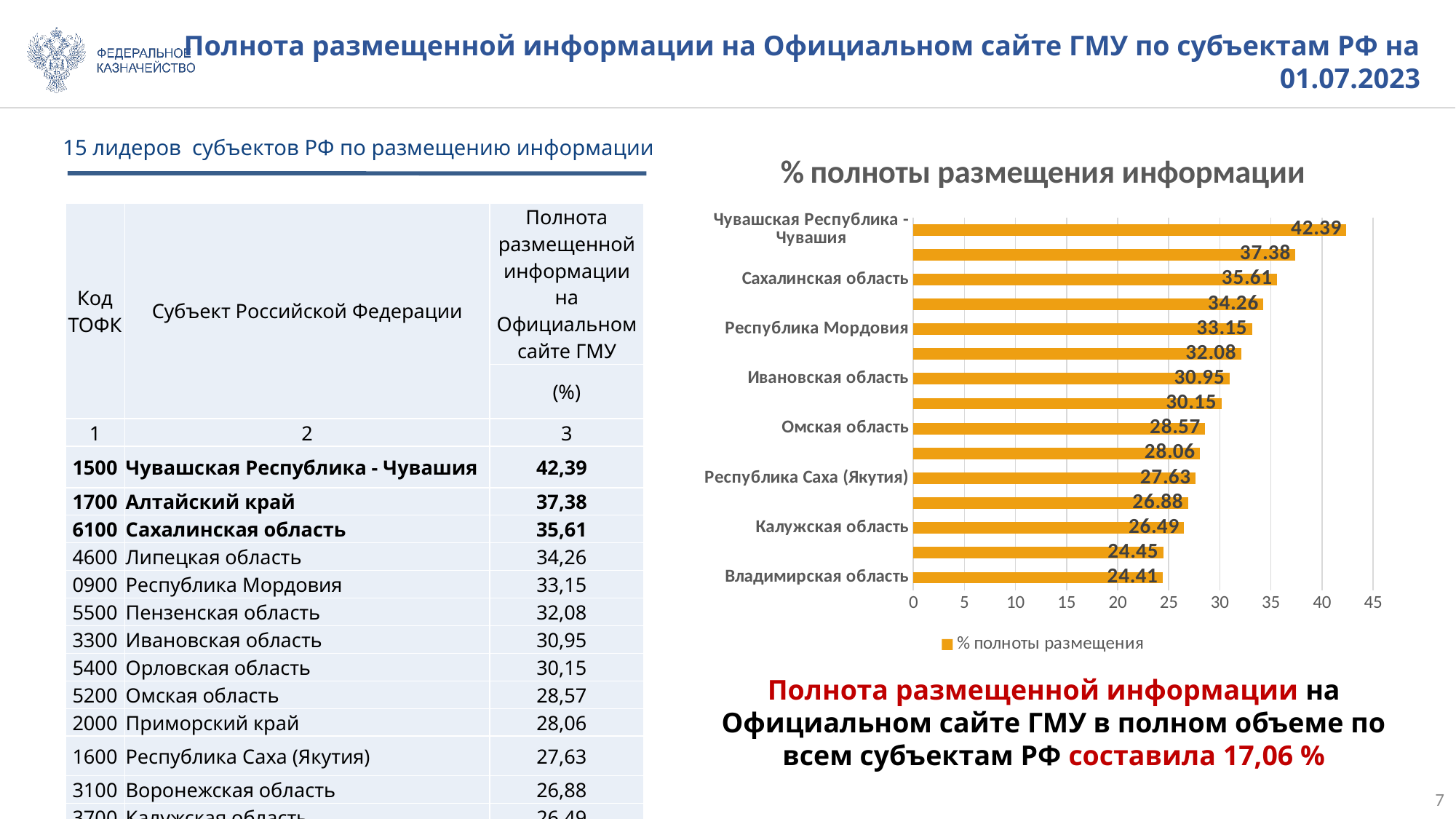
How many bars are plotted in the chart "% полноты размещения информации"? 15 What is the value for Владимирская область in the chart? 24.41 Is the value for Калужская область greater or less than 25? greater Which region has the highest value in the chart? Чувашская Республика - Чувашия How many series does the legend of the chart list? 1 What is the difference between the values for Чувашская Республика - Чувашия and Сахалинская область? 6.78 What is the legend entry shown below the chart? % полноты размещения What is the value for Чувашская Республика - Чувашия in the chart? 42.39 Which has the larger value, Республика Мордовия or Ивановская область? Республика Мордовия What is the value for Сахалинская область in the chart? 35.61 What is the value for Республика Саха (Якутия) in the chart? 27.63 What kind of chart is shown on the slide? bar chart